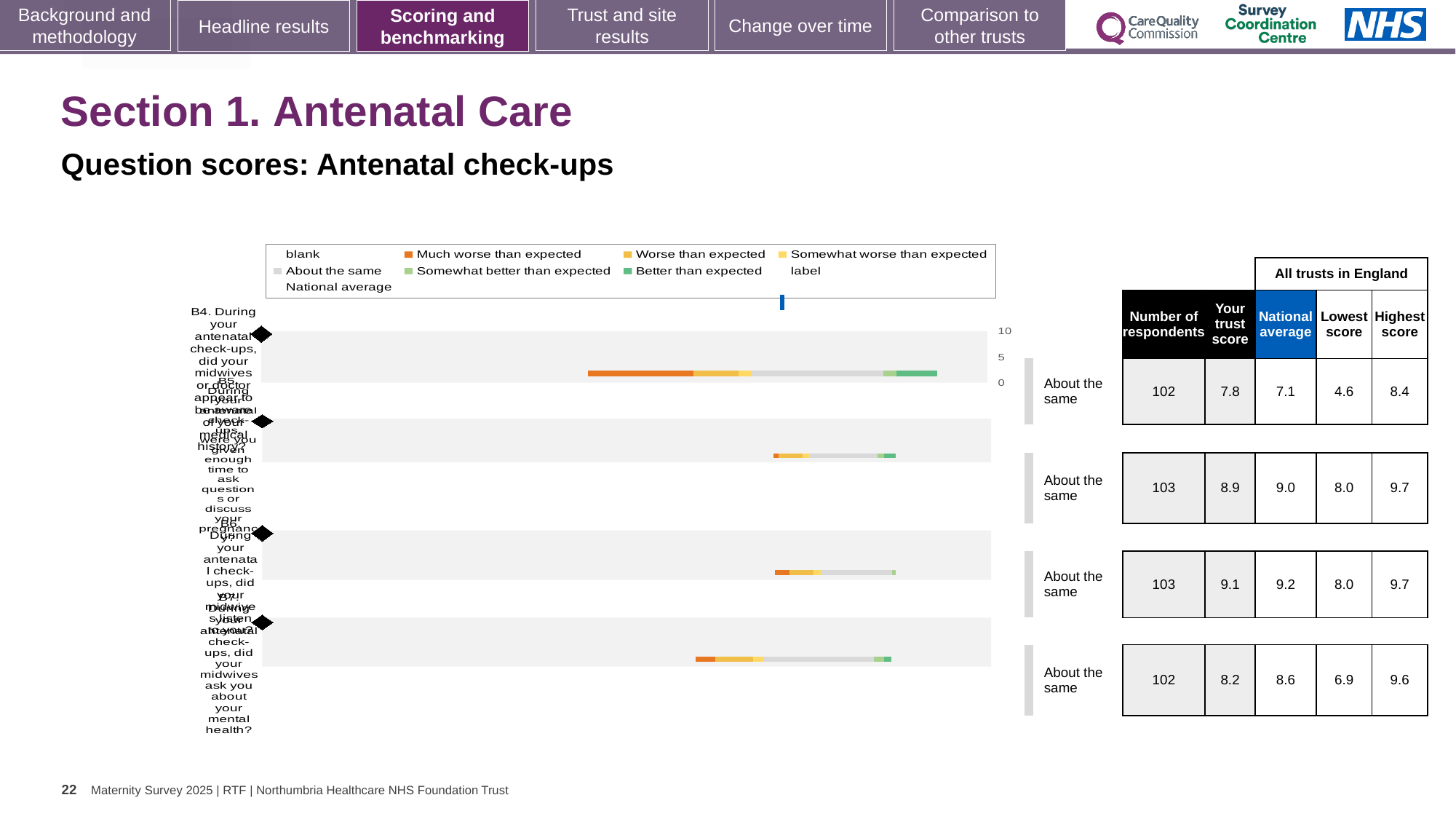
For B4, is the trust score or the national average larger? trust score In the table, what is the national average for B6 (midwives listen to you)? 9.2 In the table, what is the trust score for B4 (midwives or doctor appear to be aware of your medical history)? 7.8 In the table, how many respondents answered B7 (midwives ask you about your mental health)? 102 Which colour in the legend represents 'Much worse than expected'? orange How many questions (bars) are plotted in the chart? 4 What is the title of the slide's chart section? Question scores: Antenatal check-ups What is the lowest score among all trusts in England for B7? 6.9 Which question has the lowest 'Your trust score' in the table? B4 Which question has the highest 'Your trust score' in the table? B6 What kind of chart is shown on the slide? bar chart What is the difference between the trust score and the national average for B4? 0.7